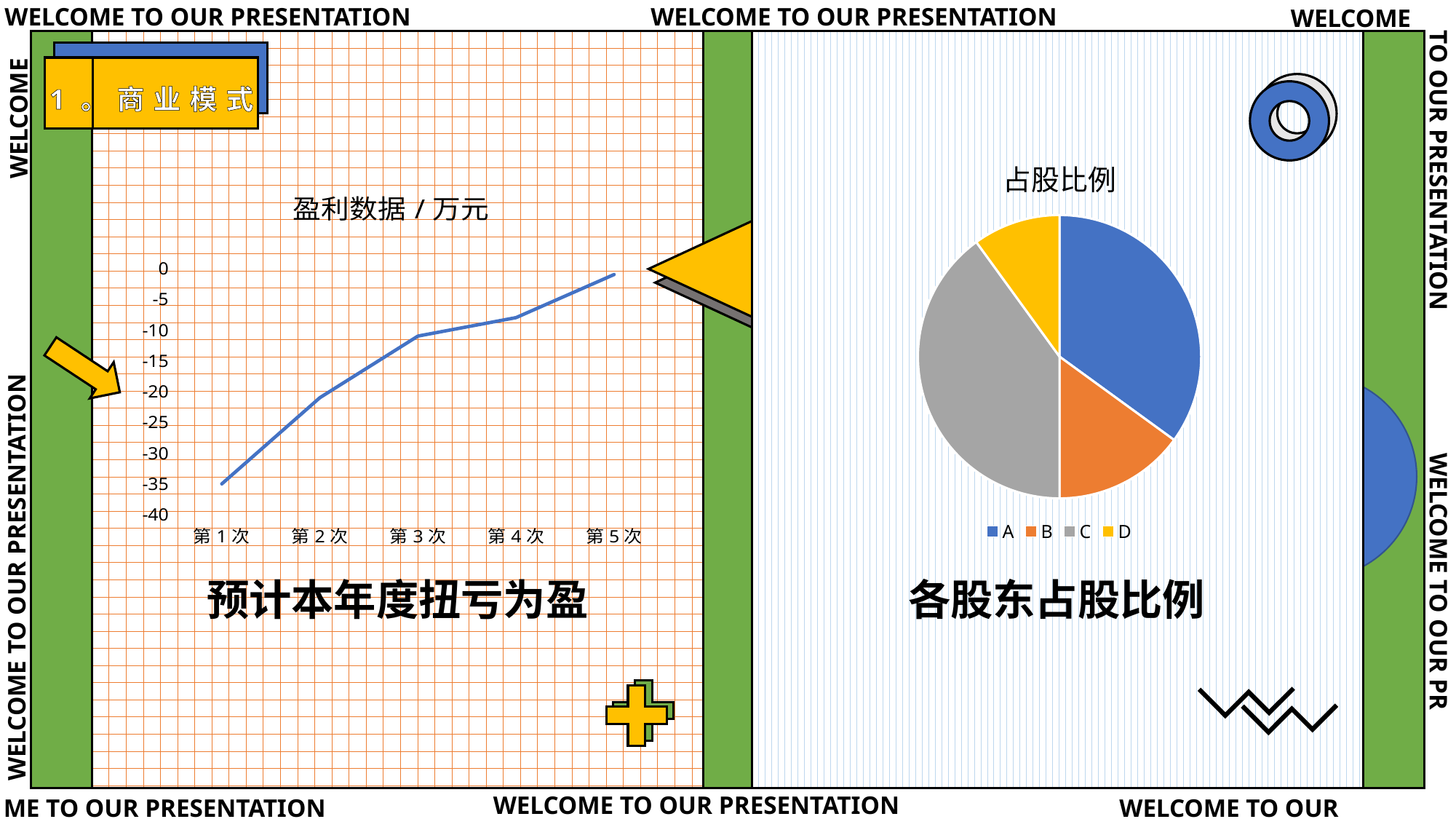
In the chart titled 盈利数据 / 万元, is the value for 第2次 greater or less than -25? greater In the chart titled 占股比例, how many entries does the legend list? 4 In the chart titled 盈利数据 / 万元, is the value for 第1次 greater or less than -30? less In the chart titled 占股比例, which slice is the largest? C What kind of chart is the chart titled 占股比例? pie chart In the chart titled 盈利数据 / 万元, is the value for 第3次 greater or less than -15? greater In the chart titled 盈利数据 / 万元, which category has the highest value? 第5次 In the chart titled 盈利数据 / 万元, how many points are plotted along the x axis? 5 In the chart titled 盈利数据 / 万元, do the values rise or fall from 第1次 to 第5次? rise What kind of chart is the chart titled 盈利数据 / 万元? line chart In the chart titled 占股比例, which slice is the smallest? D In the chart titled 盈利数据 / 万元, which category has the lowest value? 第1次